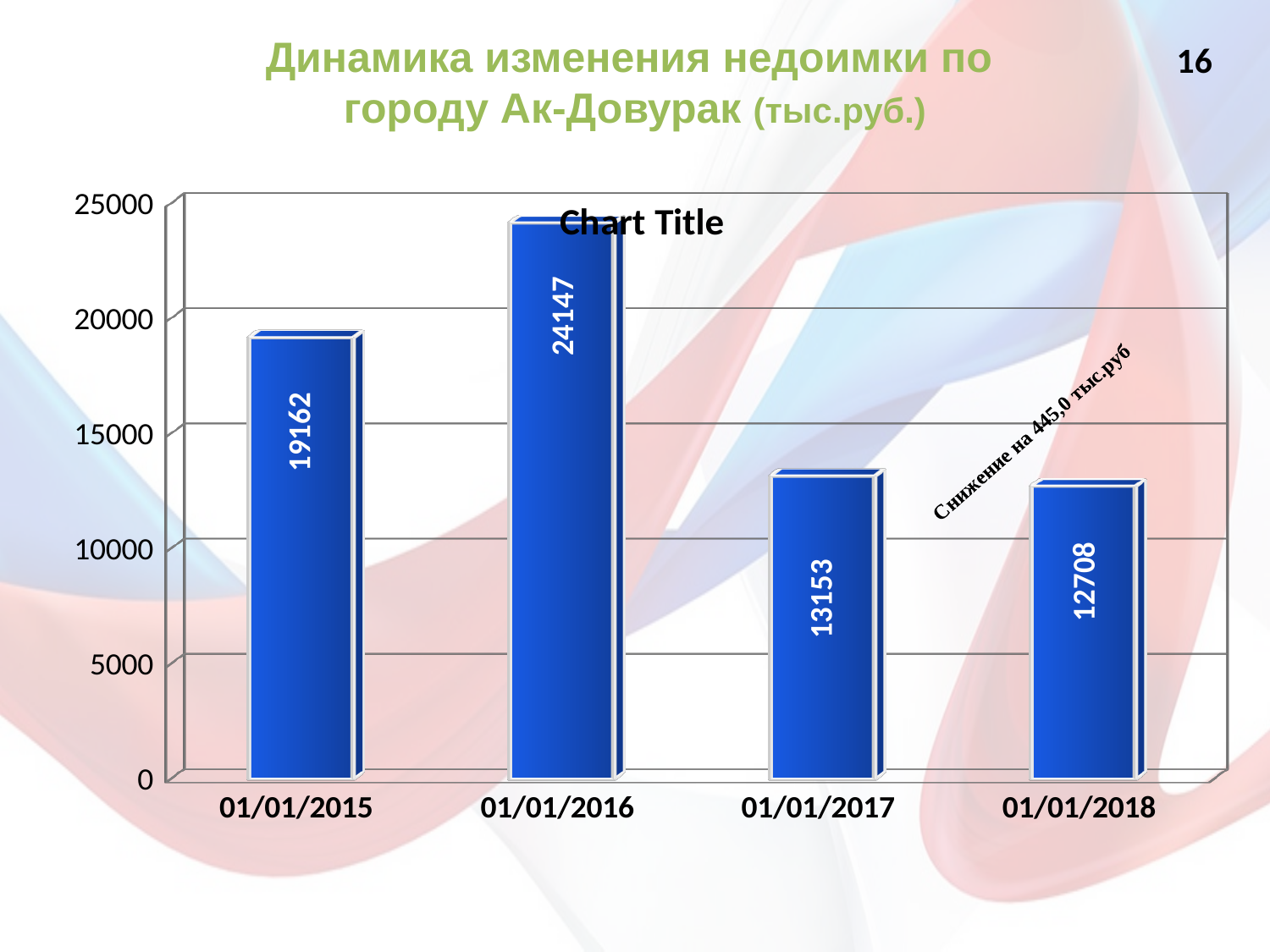
What is the value for 01/01/2015? 19162 Which date has the lowest value? 01/01/2018 Which is larger, the value for 01/01/2015 or the value for 01/01/2017? 01/01/2015 What is the value for 01/01/2018? 12708 What kind of chart is shown on the slide? Bar chart What is the difference between the values for 01/01/2017 and 01/01/2018? 445 What unit is given in the slide title for the values? тыс.руб. What is the difference between the values for 01/01/2016 and 01/01/2015? 4985 What is the value for 01/01/2017? 13153 What is the value for 01/01/2016? 24147 Which date has the highest value? 01/01/2016 How many dates are shown on the x axis? 4